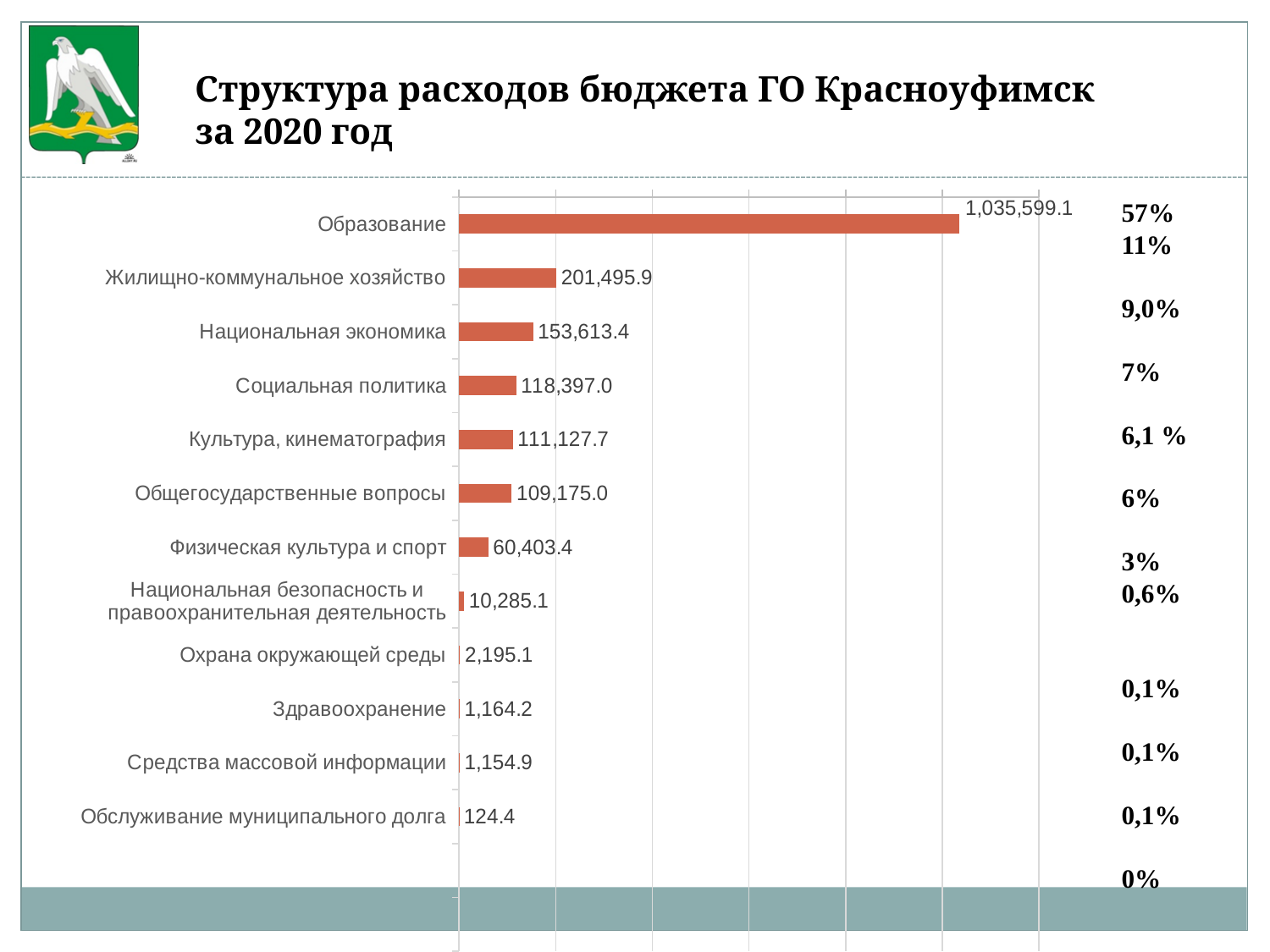
What is the difference between the values for Жилищно-коммунальное хозяйство and Национальная экономика? 47,882.5 Which is larger, the value for Социальная политика or the value for Культура, кинематография? Социальная политика What is the value for Жилищно-коммунальное хозяйство? 201,495.9 What kind of chart is shown on the slide? Bar chart What is the difference between the values for Здравоохранение and Средства массовой информации? 9.3 Which category has the lowest value? Обслуживание муниципального долга What is the value for Физическая культура и спорт? 60,403.4 How many categories are shown in the chart? 12 What is the value for Образование? 1,035,599.1 What is the title of the slide? Структура расходов бюджета ГО Красноуфимск за 2020 год Which category has the highest value? Образование What is the value for Обслуживание муниципального долга? 124.4